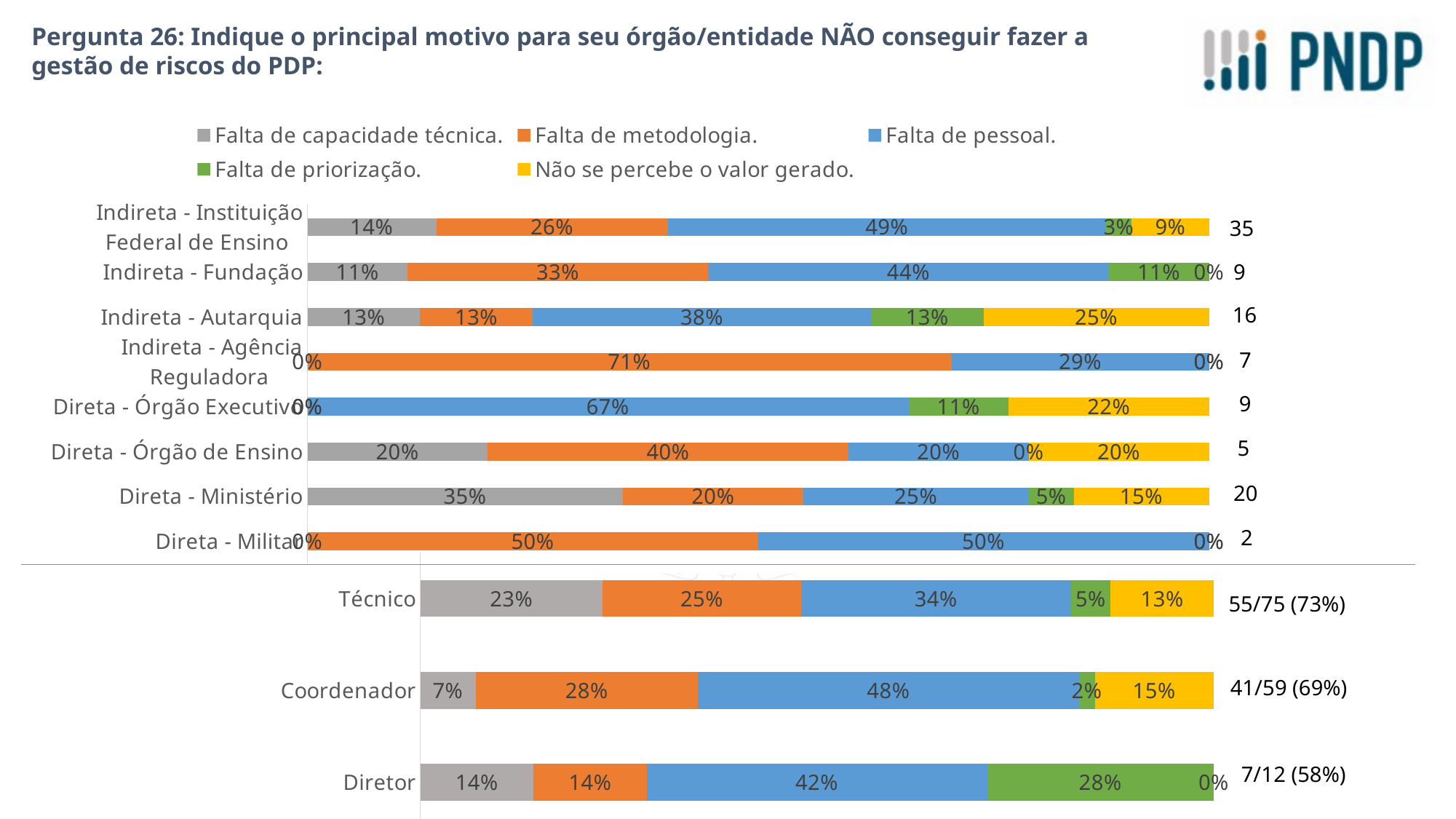
In the bottom chart, which role has the highest 'Falta de priorização' percentage? Diretor How many series does the legend list? 5 In the top chart, how many organization categories are shown? 8 In the top chart, what percentage of Indireta - Instituição Federal de Ensino respondents chose 'Falta de pessoal'? 49% In the bottom chart, is the 'Falta de capacidade técnica' value larger for Técnico or for Coordenador? Técnico What type of chart is used on this slide? Stacked bar chart In the top chart, which category has the highest 'Falta de capacidade técnica' percentage? Direta - Ministério In the top chart, what is the 'Não se percebe o valor gerado' value for Indireta - Autarquia? 25% In the top chart, what percentage of Indireta - Agência Reguladora respondents chose 'Falta de metodologia'? 71% In the bottom chart, what percentage of Coordenador respondents chose 'Falta de pessoal'? 48% In the bottom chart, what response count and rate is shown next to the Técnico bar? 55/75 (73%) In the top chart, what is the difference between the 'Falta de metodologia' and 'Falta de capacidade técnica' values for Direta - Órgão de Ensino? 20%